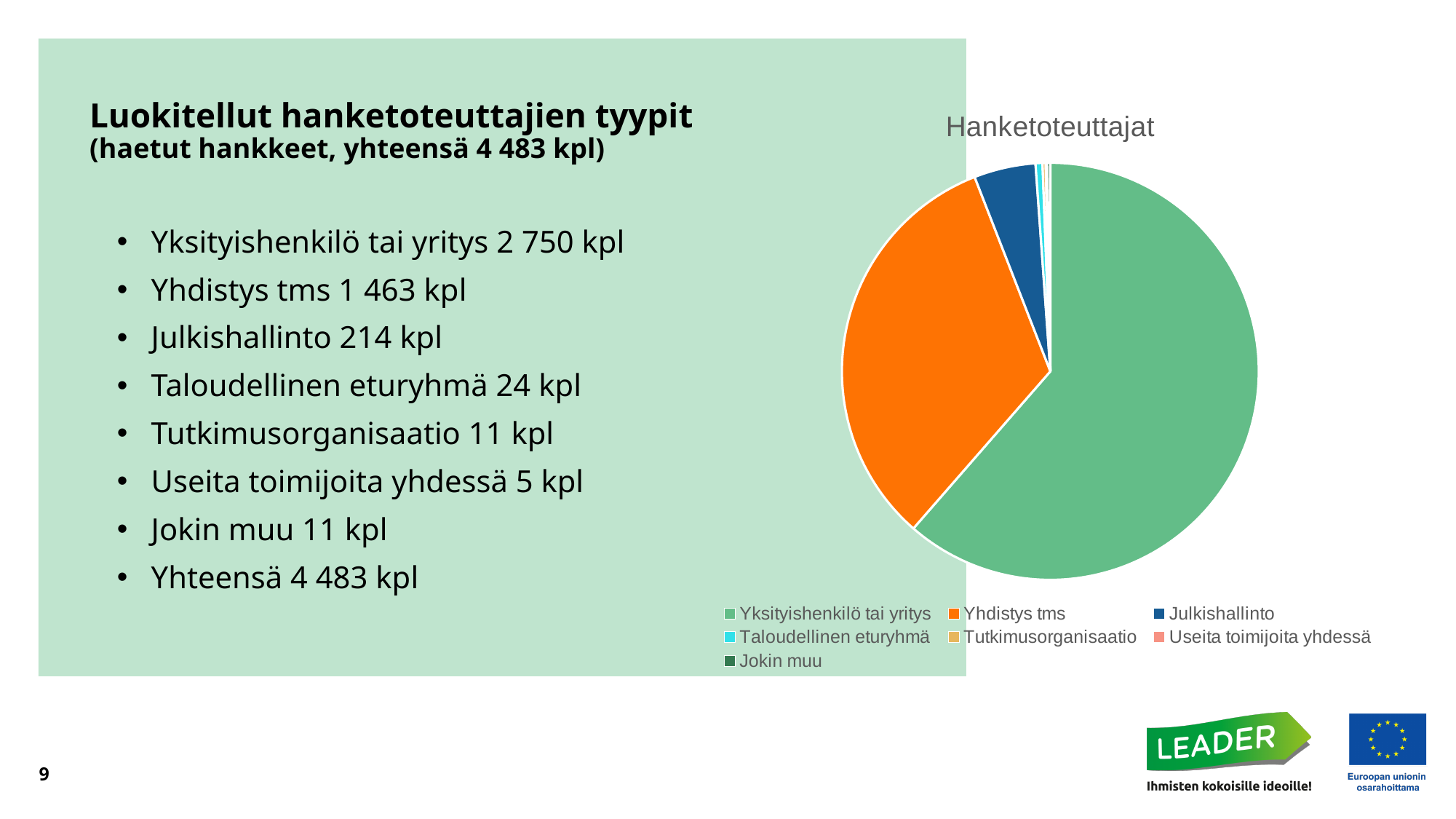
What is the value for Julkishallinto? 214 kpl What is the title of the chart? Hanketoteuttajat What is the difference between the values for Yksityishenkilö tai yritys and Yhdistys tms? 1 287 kpl How many categories does the chart's legend list? 7 Which category has the largest slice of the pie? Yksityishenkilö tai yritys What kind of chart is shown on the slide? pie chart What is the value for Yksityishenkilö tai yritys? 2 750 kpl What colour is the Yhdistys tms slice? orange What is the value for Yhdistys tms? 1 463 kpl Which category has the smallest value according to the slide? Useita toimijoita yhdessä Which is larger, the slice for Yhdistys tms or the slice for Julkishallinto? Yhdistys tms What is the total of all categories in the chart? 4 483 kpl